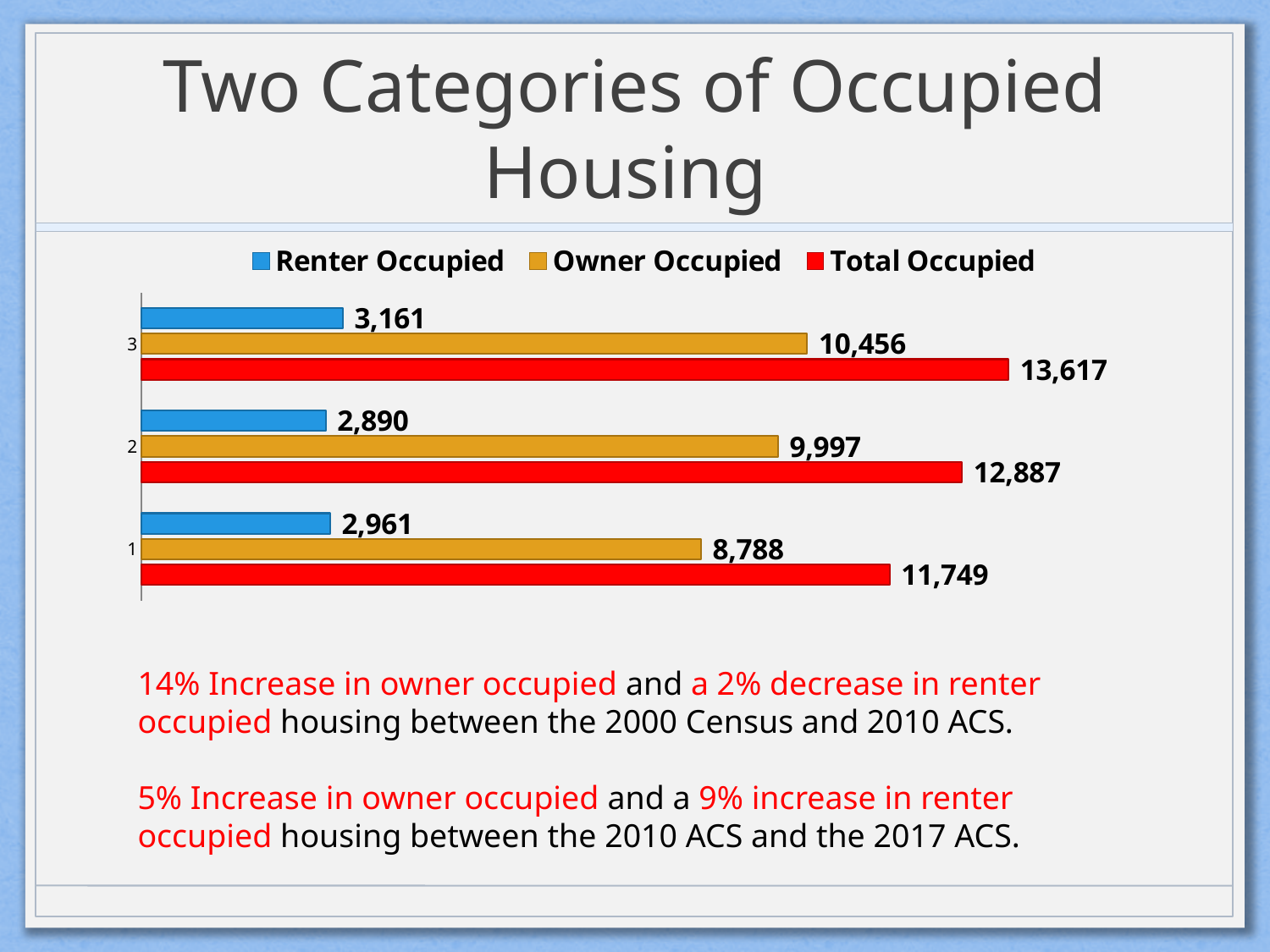
How many categories are shown on the chart? 3 What kind of chart is shown on the slide? bar chart What is the difference between the Owner Occupied values for category 3 and category 2? 459 Do the Owner Occupied values rise or fall from category 1 to category 3? rise Which is larger, the Renter Occupied value for category 1 or for category 3? category 3 What is the Renter Occupied value for category 2? 2,890 How many series does the legend list? 3 What is the Owner Occupied value for category 1? 8,788 Which category has the highest Total Occupied value? 3 Which colour represents the Total Occupied series? red What is the Total Occupied value for category 3? 13,617 Which category has the lowest Renter Occupied value? 2